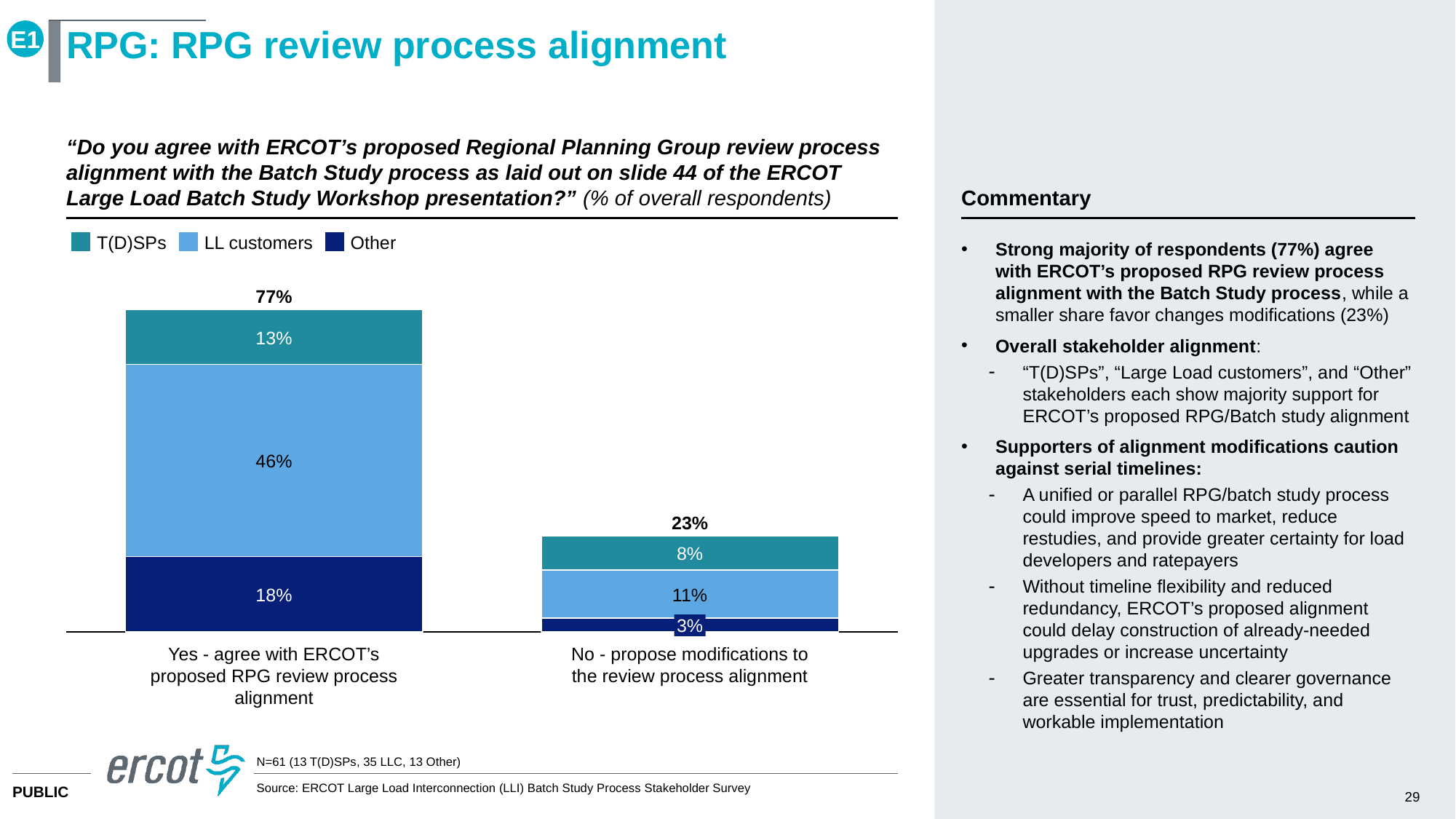
Which category has the higher total, 'Yes' or 'No'? Yes - agree with ERCOT's proposed RPG review process alignment What is the Other value for the 'Yes' category? 18% What is the total for the 'No - propose modifications to the review process alignment' bar? 23% What is the LL customers value for the 'Yes' category? 46% What is the total for the 'Yes - agree with ERCOT's proposed RPG review process alignment' bar? 77% How many series does the legend list? 3 Which is larger: the LL customers value for 'Yes' or the LL customers value for 'No'? LL customers value for 'Yes' (46%) What is the T(D)SPs value for the 'No - propose modifications' category? 8% How many categories are shown on the x axis? 2 What kind of chart is shown? Stacked bar chart What is the Other value for the 'No - propose modifications' category? 3% What is the difference between the T(D)SPs values for the 'Yes' and 'No' categories? 5%